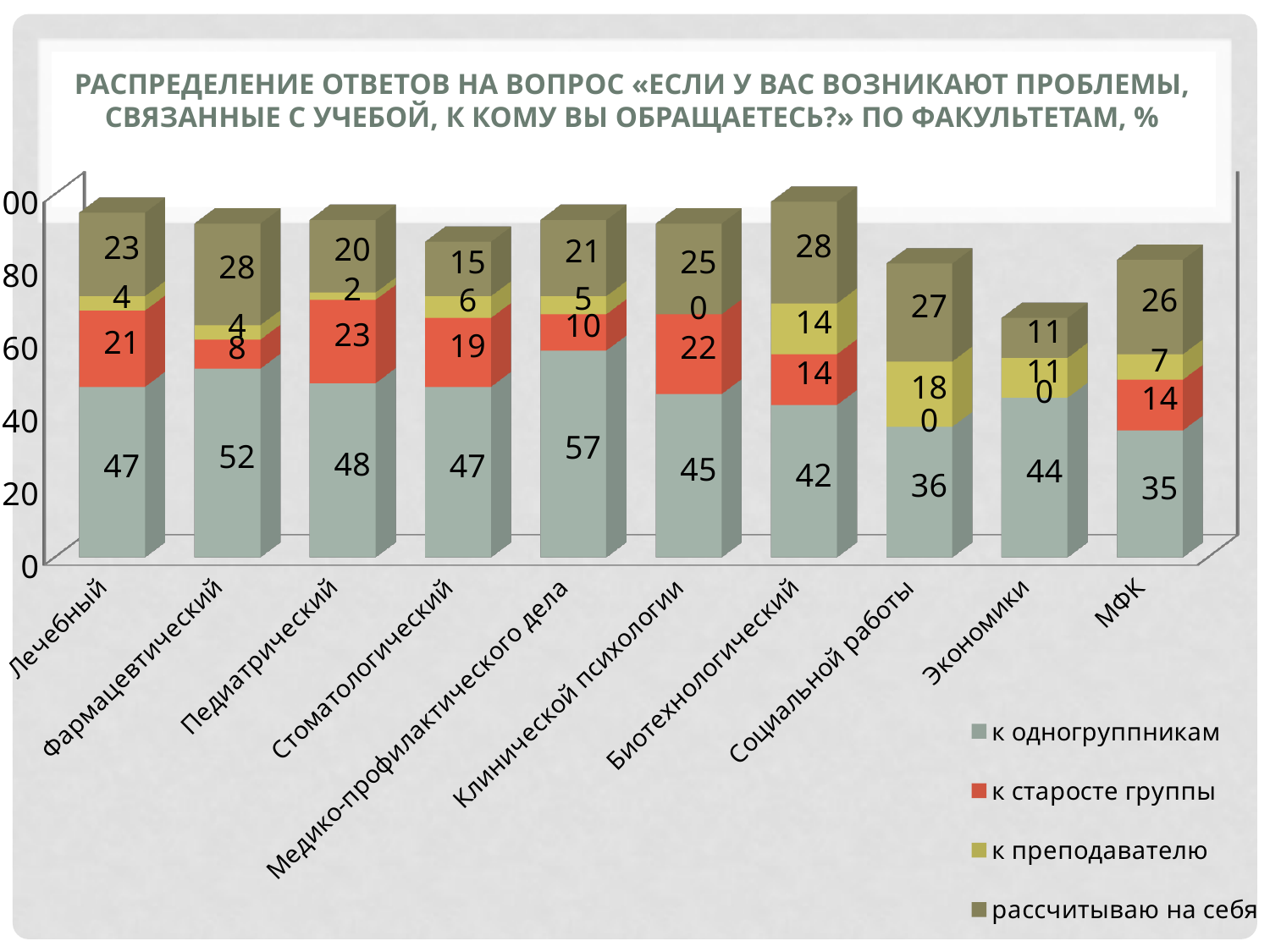
Which is larger: the 'к преподавателю' value for Биотехнологический or for Стоматологический? Биотехнологический What is the total of the stacked bar for the Экономики faculty? 66 Which faculty has the lowest value for 'к одногруппникам'? МФК What is the value for 'рассчитываю на себя' for the Социальной работы faculty? 27 What kind of chart is shown on the slide? Stacked bar chart How many faculties are shown on the x axis? 10 What is the difference between the 'к одногруппникам' values for Фармацевтический and Биотехнологический? 10 What percentage of students at the Медико-профилактического дела faculty turn to their groupmates (к одногруппникам)? 57 How many series does the legend list? 4 What is the value for 'к старосте группы' for the Педиатрический faculty? 23 Which faculty has the highest value for 'к одногруппникам'? Медико-профилактического дела Which legend entry corresponds to the red segments of the bars? к старосте группы